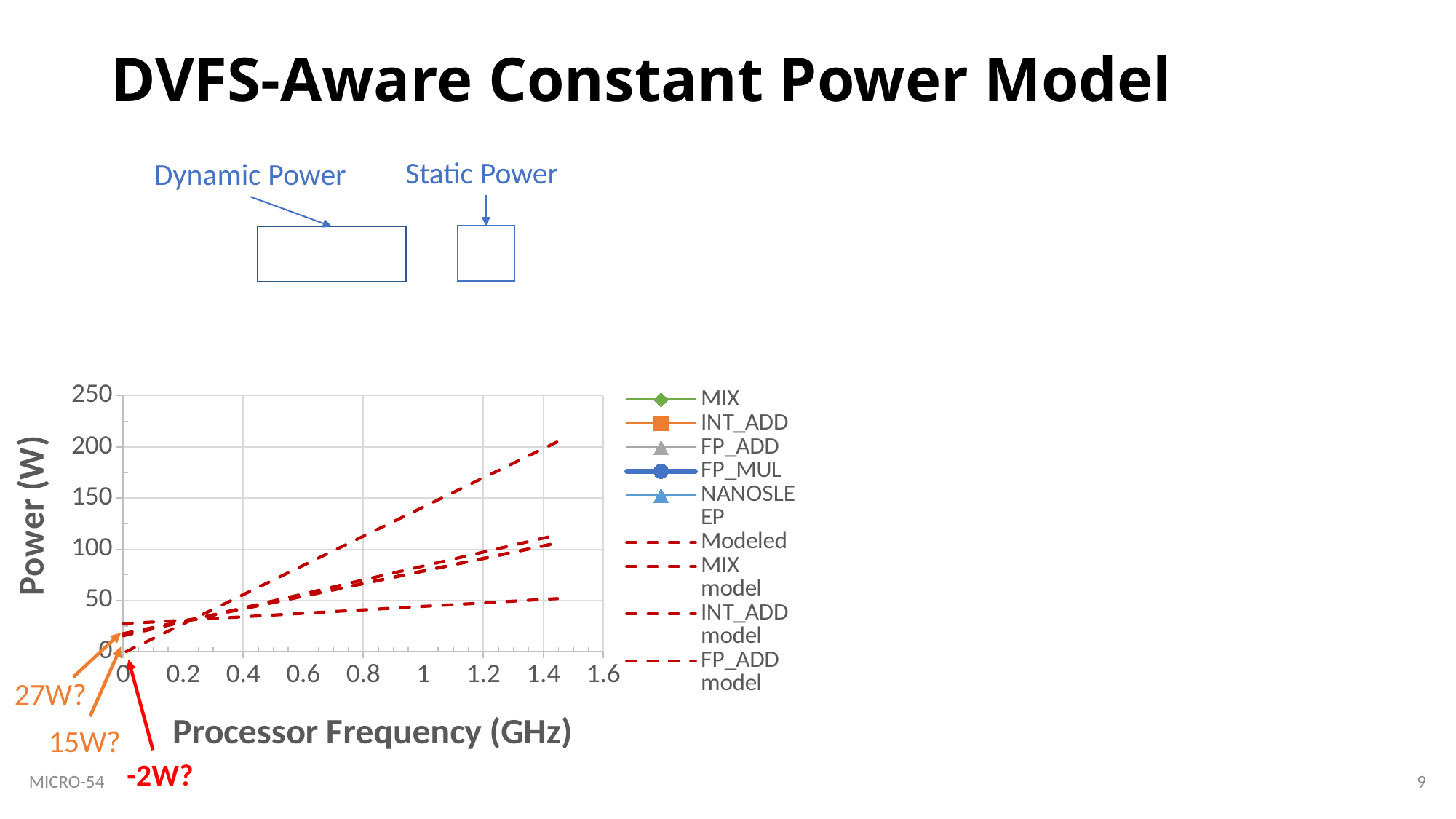
Do the plotted dashed lines rise or fall as processor frequency increases? rise Is the value of the steepest dashed line at 1.4 GHz greater or less than 150? greater Is the value of the steepest dashed line at 0.8 GHz greater or less than 50? greater Is the value of the lowest dashed line at 1.4 GHz greater or less than 100? less What is the title of the chart's y axis? Power (W) What kind of chart is shown on the slide? line chart What is the highest value shown on the x axis? 1.6 How many series does the chart's legend list? 9 What is the highest value shown on the y axis? 250